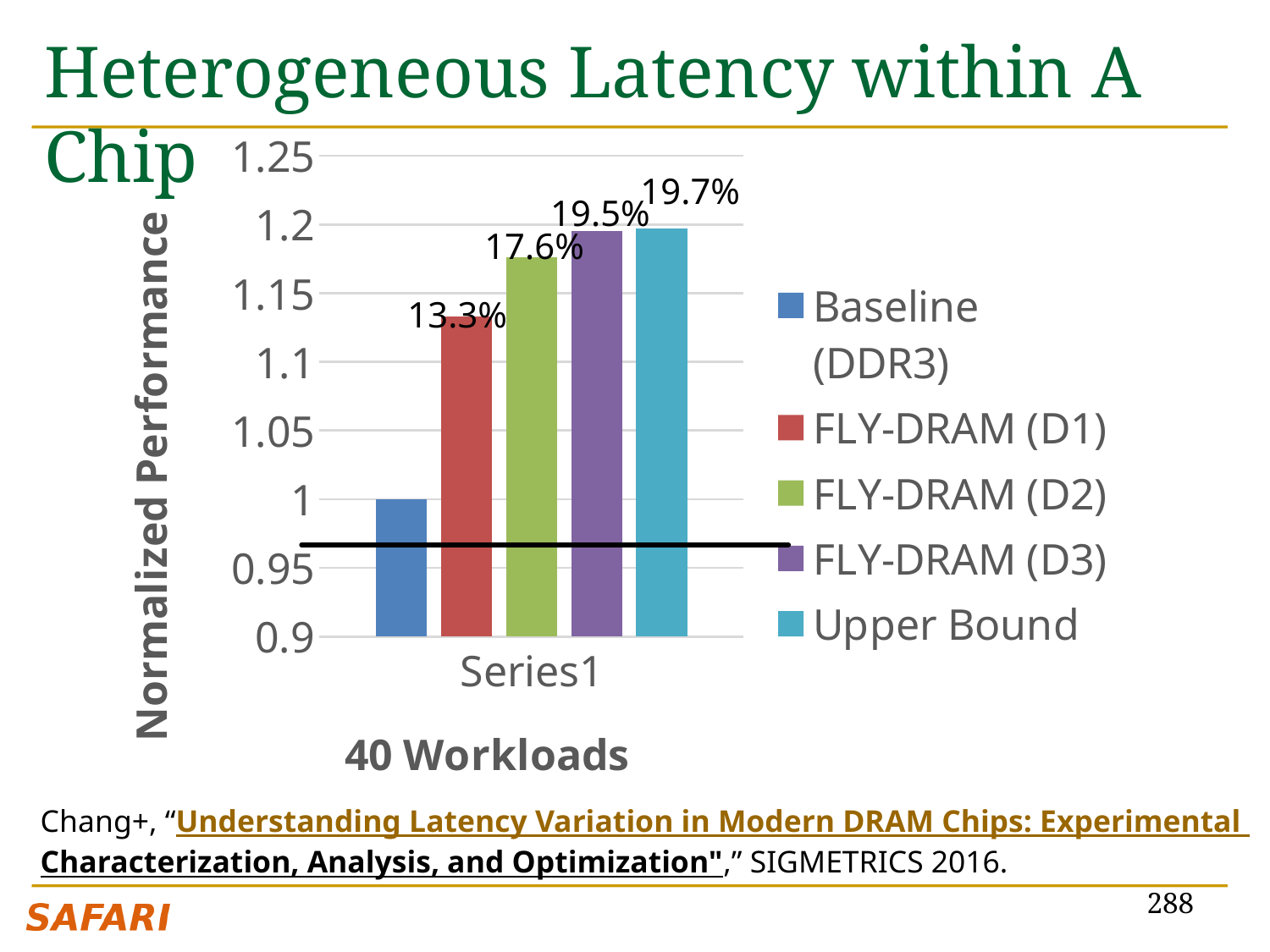
What kind of chart is shown on the slide? bar chart What data label is shown on the FLY-DRAM (D2) bar? 17.6% Is the normalized performance for FLY-DRAM (D1) greater or less than 1.1? greater Which series has the tallest bar? Upper Bound Which series has the shortest bar? Baseline (DDR3) What data label is shown on the FLY-DRAM (D3) bar? 19.5% What normalized performance value does the Baseline (DDR3) bar reach? 1 What data label is shown on the Upper Bound bar? 19.7% Which has the larger labeled improvement, FLY-DRAM (D1) or FLY-DRAM (D2)? FLY-DRAM (D2) What is the title of the vertical axis? Normalized Performance How many series does the legend list? 5 What data label is shown on the FLY-DRAM (D1) bar? 13.3%